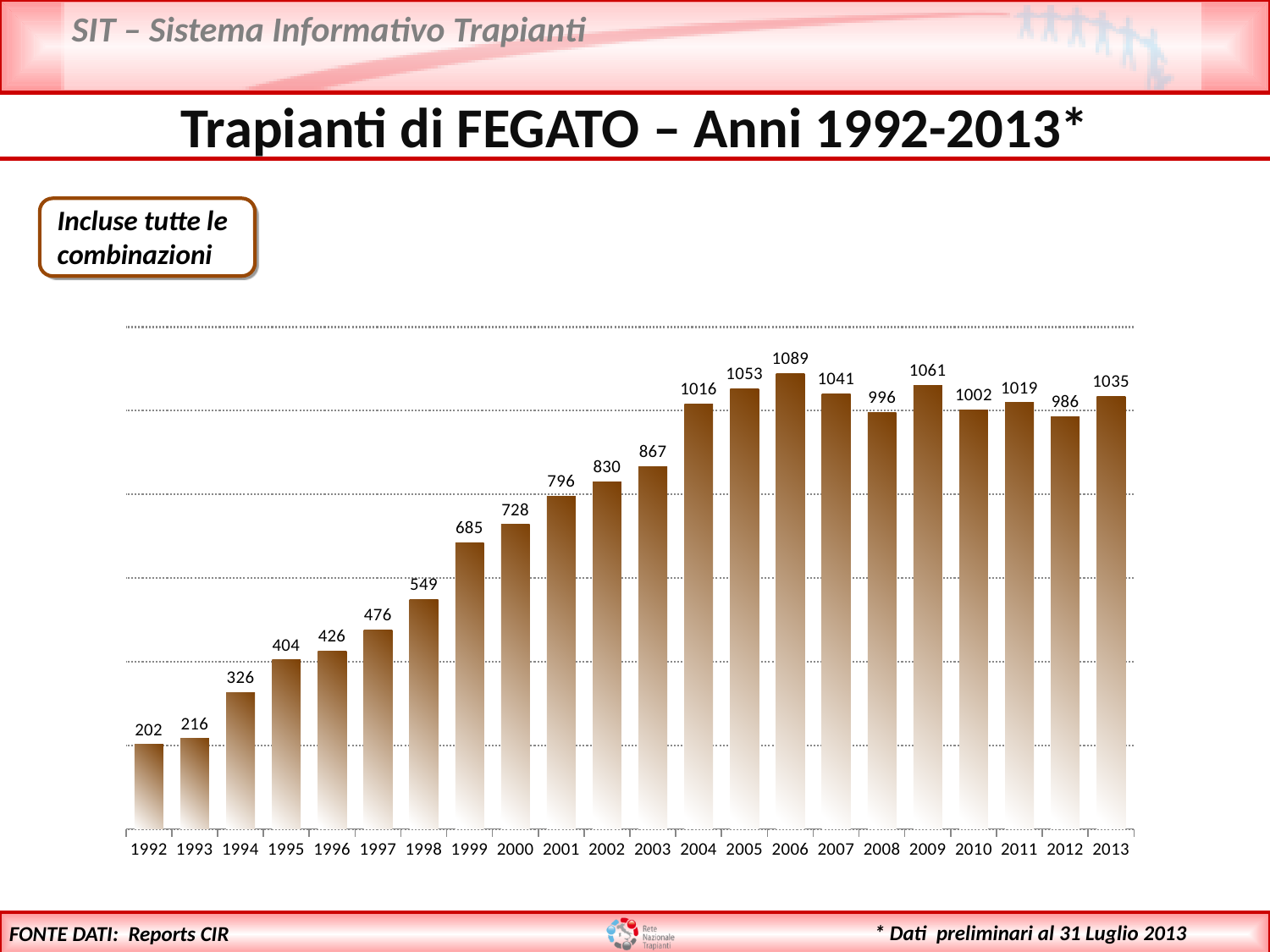
What kind of chart is this? bar chart What is the value for 1992? 202 What is the value for 2013? 1035 How many years are shown on the x axis? 22 What is the value for 1999? 685 What is the difference between the values for 2006 and 1992? 887 Which is larger, the value for 2009 or the value for 2010? 2009 What is the value for 2006? 1089 Which year has the lowest value? 1992 Do the values generally rise or fall from 1992 to 2006? rise Which year has the highest value? 2006 What is the difference between the values for 2013 and 2012? 49